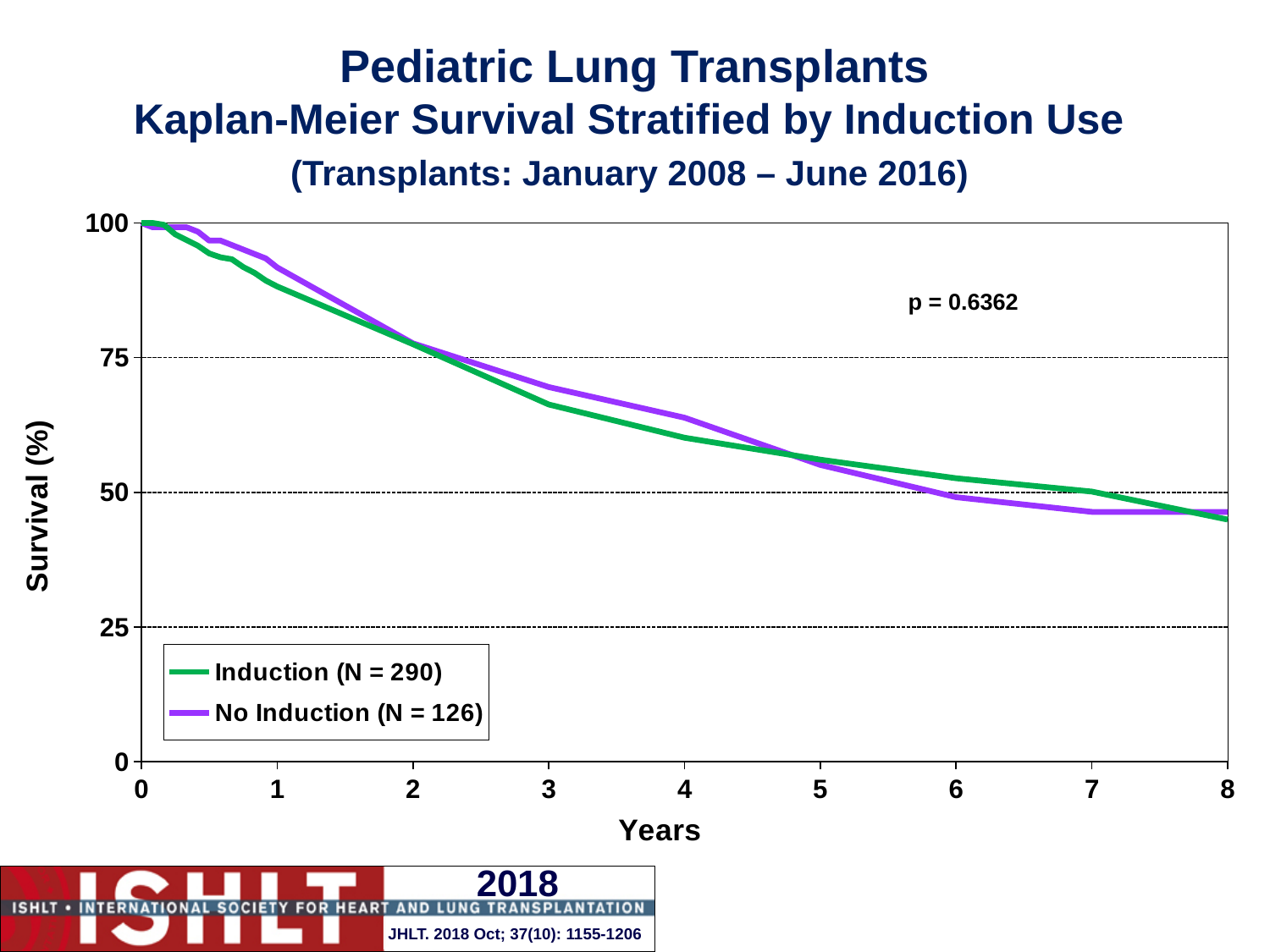
Is the survival value for Induction at year 3 greater or less than 75? less Is the survival value for Induction at year 1 greater or less than 75? greater At year 6, which group has the higher survival, Induction or No Induction? Induction At year 1, which group has the higher survival, Induction or No Induction? No Induction What is the N for the Induction group shown in the legend? 290 Is the survival value for Induction at year 8 greater or less than 50? less What kind of chart is shown on the slide? Line chart How many series does the legend list? 2 What p-value is printed on the chart? p = 0.6362 Do the survival curves rise or fall as the years increase? Fall